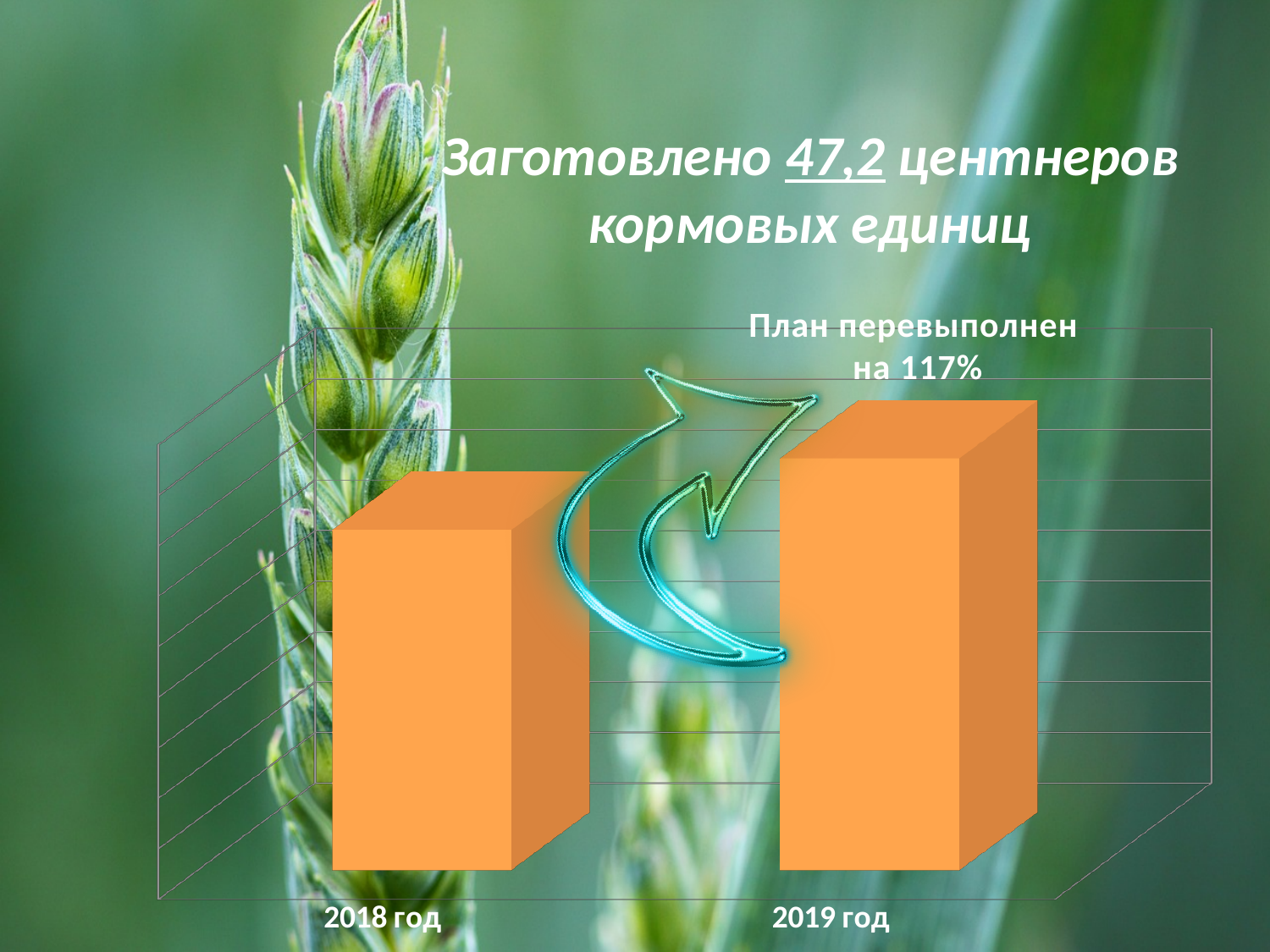
Do the bar values rise or fall from 2018 год to 2019 год? rise What colour are the bars in the chart? orange Which category has the highest bar? 2019 год What kind of chart is shown on the slide? bar chart Which category has the lowest bar? 2018 год What are the two category labels on the x axis? 2018 год, 2019 год How many bars does the chart have? 2 Which year has the taller bar, 2018 год or 2019 год? 2019 год